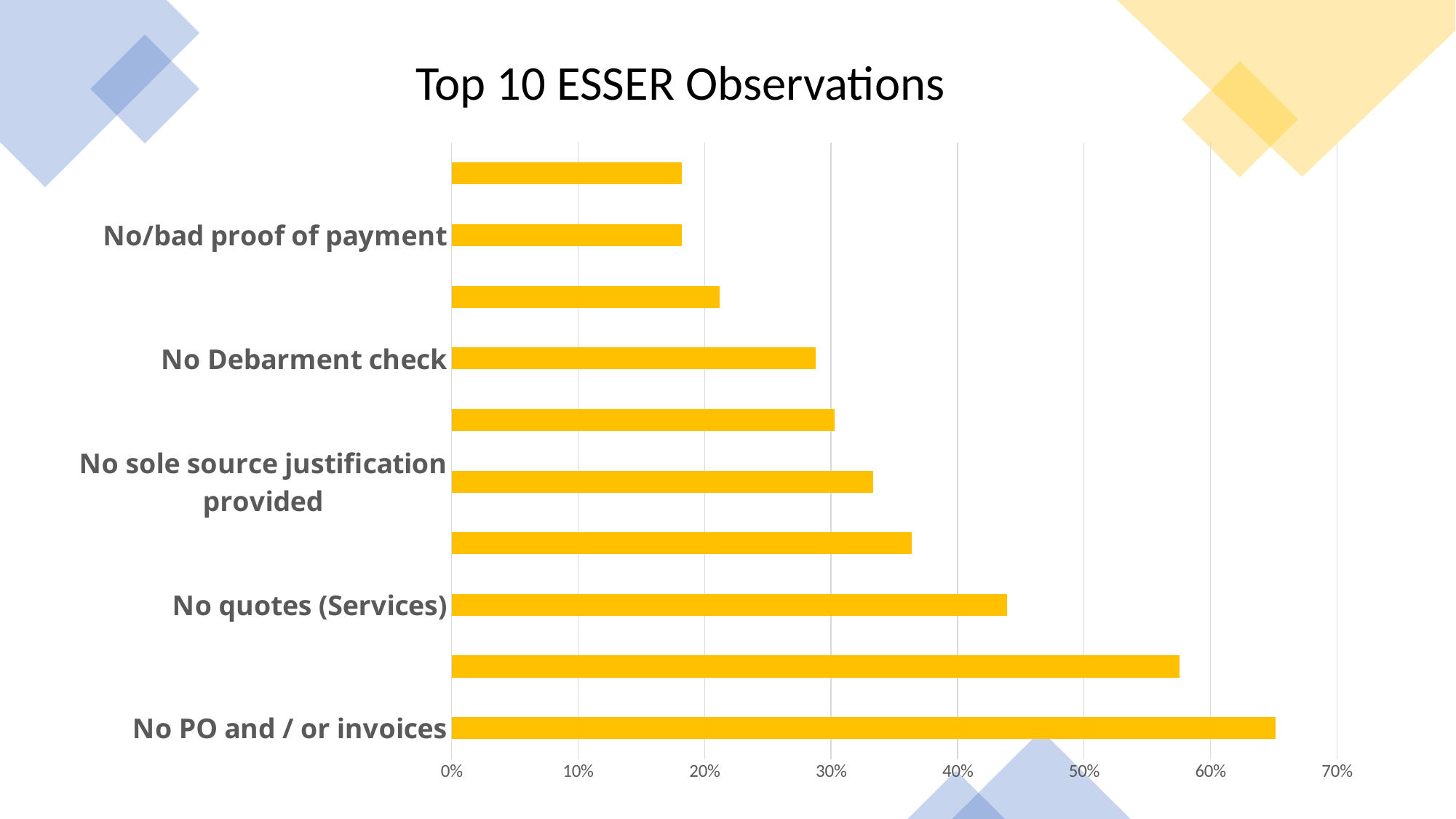
Is the value for No quotes (Services) greater or less than 40%? greater Which is larger, the value for No PO and / or invoices or the value for No sole source justification provided? No PO and / or invoices Is the value for No Debarment check greater or less than 20%? greater Is the value for No/bad proof of payment greater or less than 20%? less What kind of chart is shown on the slide? bar chart How many bars are plotted in the chart? 10 Which is larger, the value for No quotes (Services) or the value for No Debarment check? No quotes (Services) What colour are the bars in the chart? yellow Which category has the highest value in the chart? No PO and / or invoices What is the title of the chart? Top 10 ESSER Observations